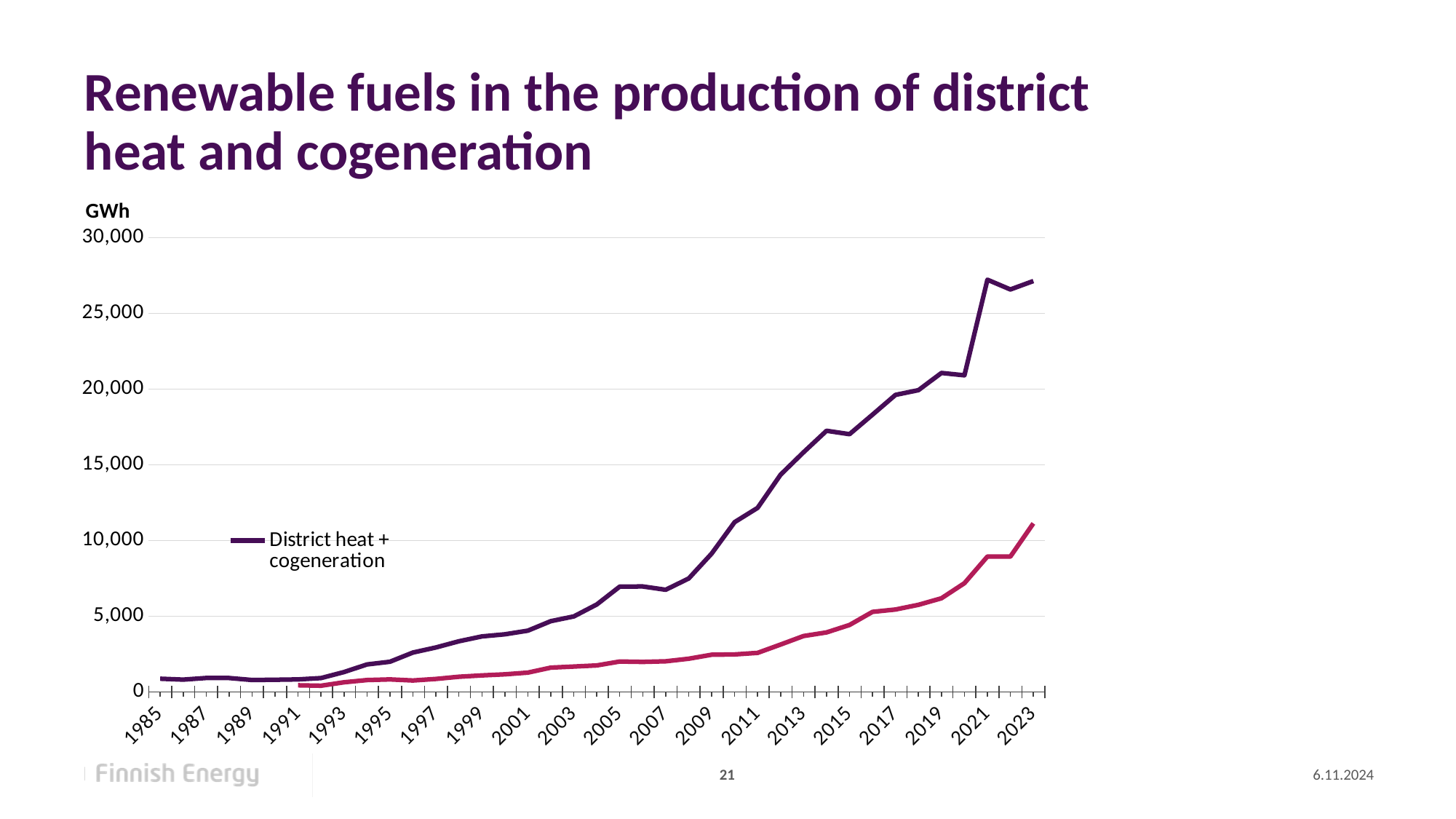
Is the value for District heat + cogeneration in 2001 greater or less than 5,000? less What unit is shown on the vertical axis of the chart? GWh What is the title of the chart on the slide? Renewable fuels in the production of district heat and cogeneration How many series does the legend list? 1 Is the value of the lower (magenta) line in 2023 greater or less than 10,000? greater Is the value for District heat + cogeneration in 2015 greater or less than 15,000? greater Does the District heat + cogeneration line generally rise or fall from 1985 to 2023? rise In 2023, which line is higher: the District heat + cogeneration line or the magenta line? District heat + cogeneration What kind of chart is shown on the slide? line chart